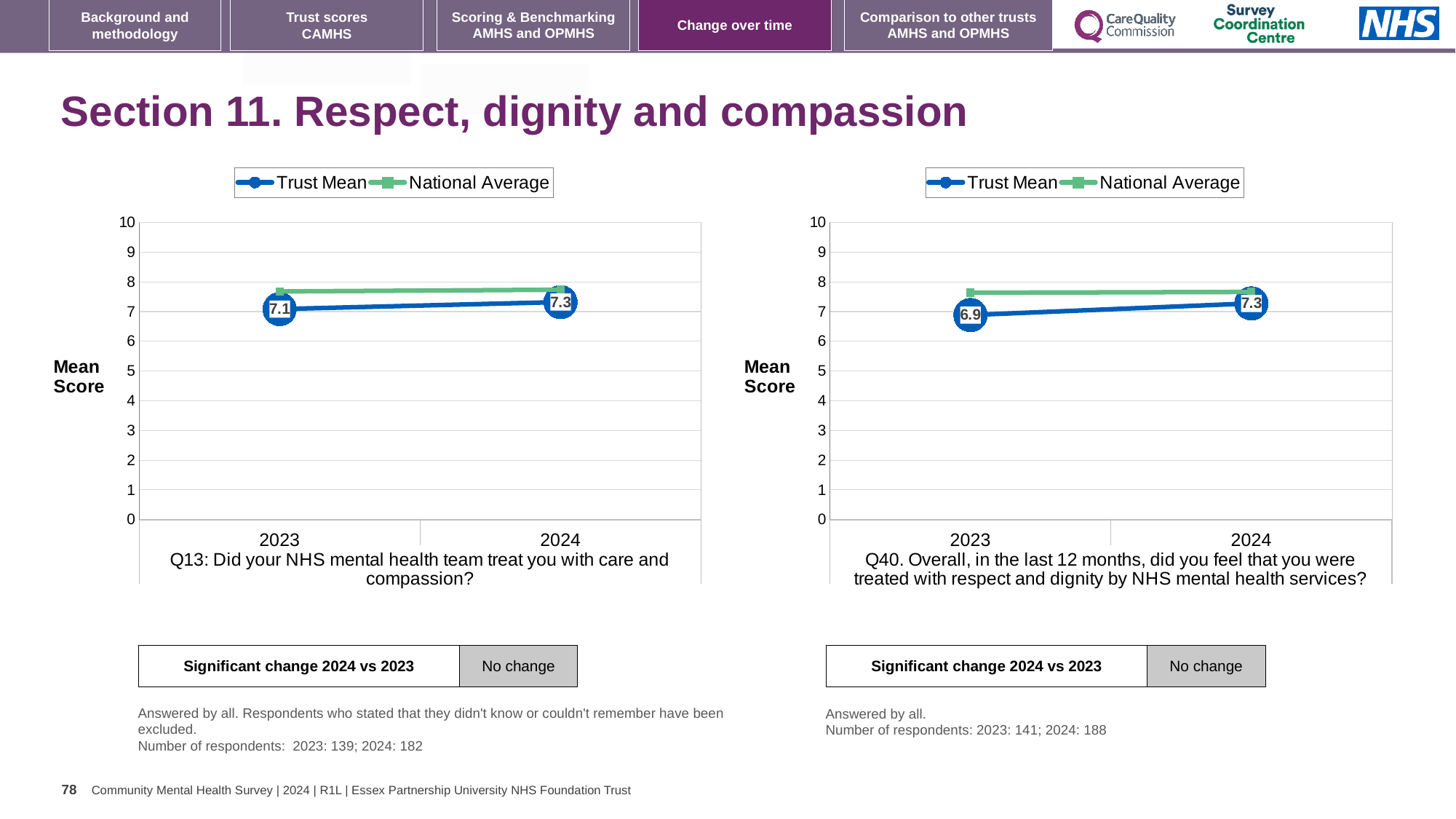
In the right chart (Q40), what is the Trust Mean for 2023? 6.9 In the left chart (Q13), by how much did the Trust Mean change from 2023 to 2024? 0.2 In the right chart (Q40), by how much did the Trust Mean change from 2023 to 2024? 0.4 What kind of chart is the right chart (Q40)? line chart In the left chart (Q13), what is the Trust Mean for 2024? 7.3 In the right chart (Q40), what is the Trust Mean for 2024? 7.3 In the right chart (Q40), is the National Average for 2023 greater or less than 7? greater In the right chart (Q40), which is higher in 2023: the Trust Mean or the National Average? National Average In the left chart (Q13), does the Trust Mean rise or fall from 2023 to 2024? rise In the left chart (Q13), what is the Trust Mean for 2023? 7.1 How many years are plotted on the x axis of the right chart (Q40)? 2 How many series does the legend of the left chart (Q13) list? 2